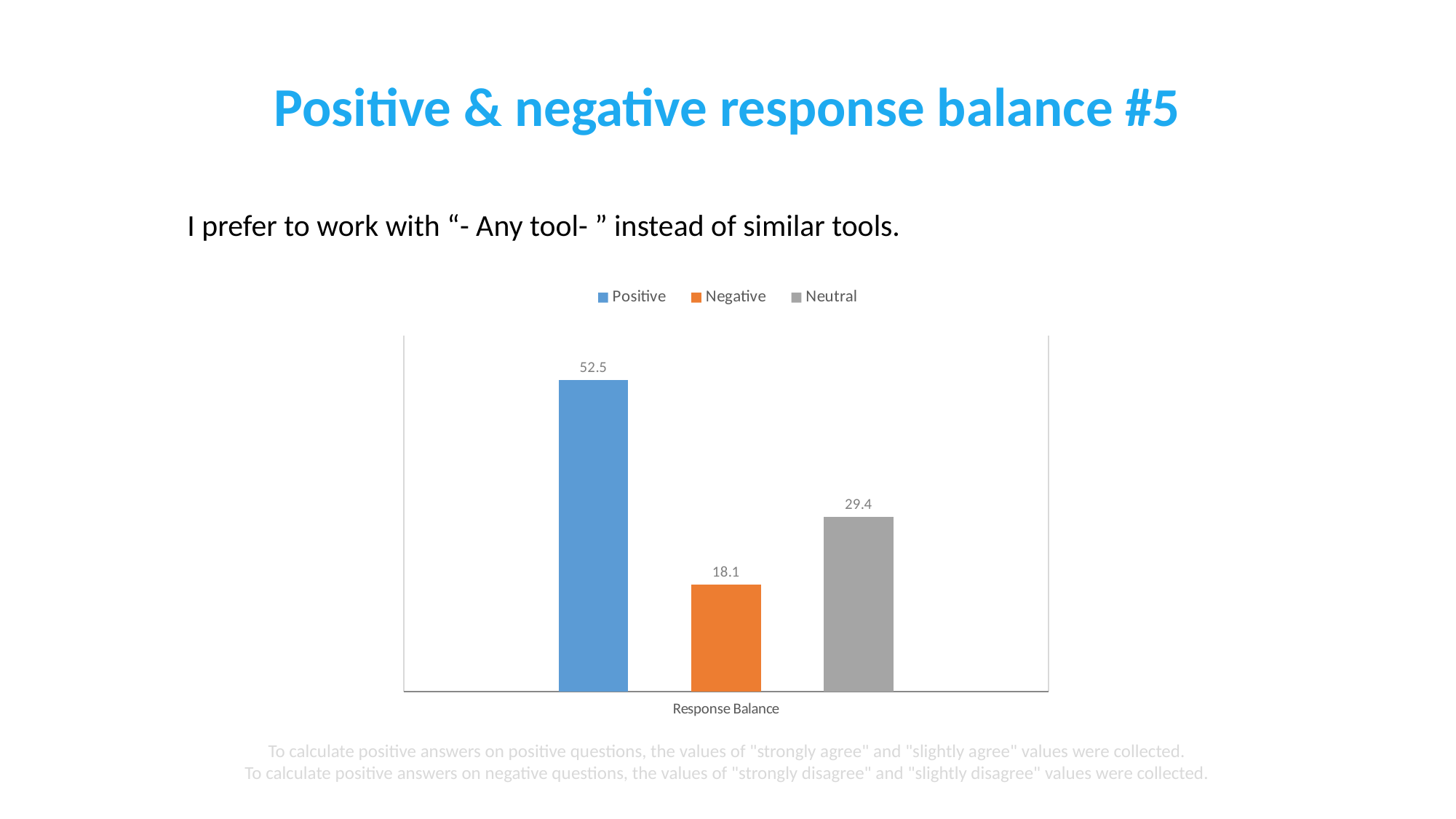
What is the value of the Negative bar? 18.1 What is the value of the Neutral bar? 29.4 What is the difference between the Neutral and Negative values? 11.3 How many series does the legend list? 3 What is the category label shown on the x axis? Response Balance What colour is the Negative bar? Orange Which series has the lowest value? Negative Which is larger, the Neutral value or the Negative value? Neutral What is the difference between the Positive and Negative values? 34.4 Which series has the highest value? Positive What is the value of the Positive bar? 52.5 What kind of chart is shown on the slide? Bar chart